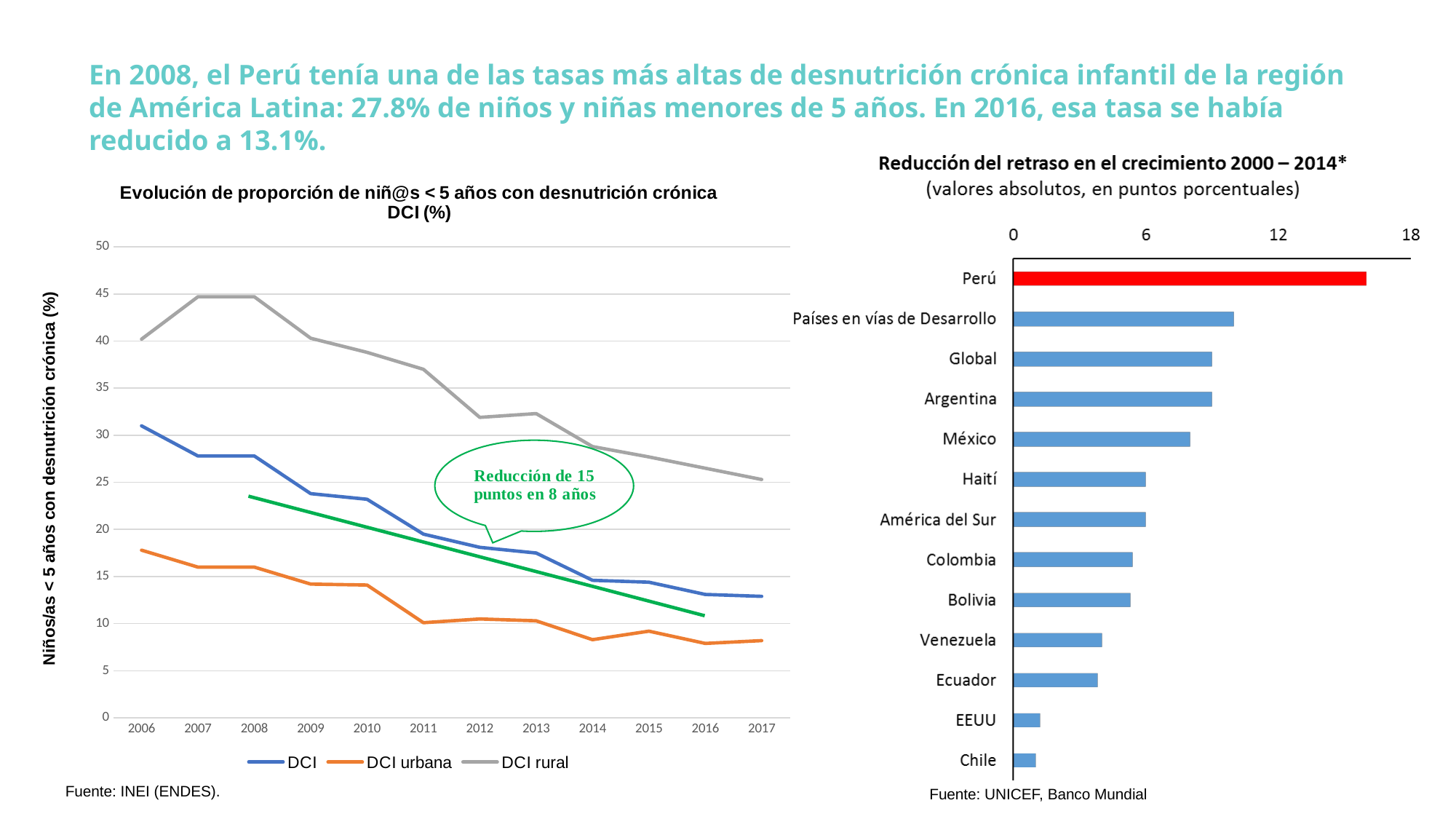
In the left chart, which series has the highest value in 2010? DCI rural In the left chart, is the value for DCI rural in 2007 greater or less than 40? greater What kind of chart is the chart on the right, 'Reducción del retraso en el crecimiento 2000 – 2014*'? bar chart In the left chart, how many years are shown on the x axis? 12 What kind of chart is the chart on the left, 'Evolución de proporción de niñ@s < 5 años con desnutrición crónica DCI (%)'? line chart In the right chart, is the value for Perú greater or less than 12? greater In the right chart, which country or region has the largest reduction? Perú In the right chart, which has the larger value, México or Haití? México In the left chart, is the value for DCI urbana in 2016 greater or less than 10? less In the right chart, how many countries or regions are listed? 13 In the left chart, does the DCI series rise or fall from 2006 to 2017? fall In the left chart, how many series does the legend list? 3